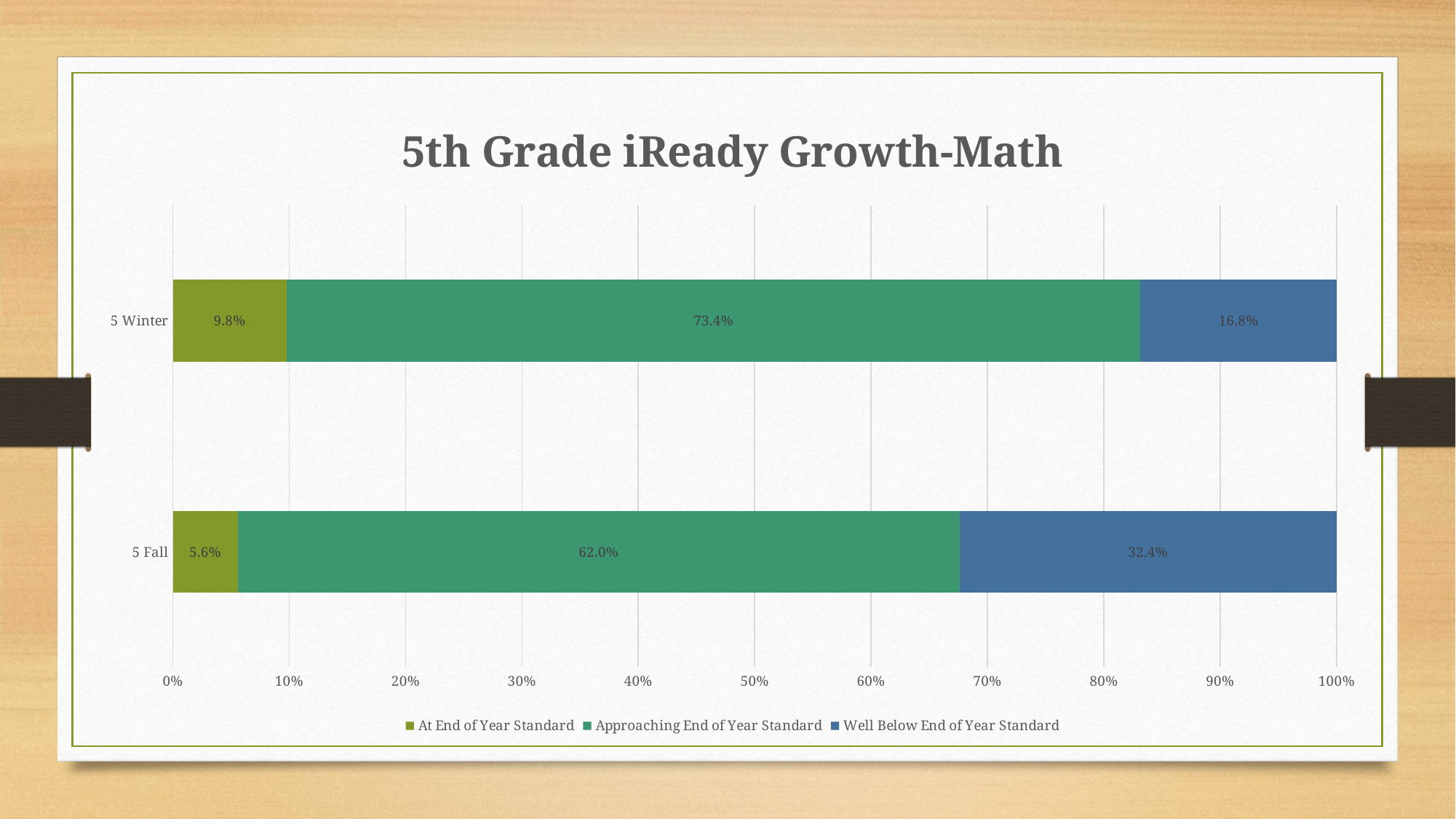
How many series does the legend list? 3 What is the value for Well Below End of Year Standard in 5 Fall? 32.4% What is the difference between the Well Below End of Year Standard values for 5 Fall and 5 Winter? 15.6% What is the value for Approaching End of Year Standard in 5 Fall? 62.0% How many categories are shown on the chart? 2 What is the value for At End of Year Standard in 5 Winter? 9.8% What is the title of the chart? 5th Grade iReady Growth-Math What is the value for Well Below End of Year Standard in 5 Winter? 16.8% What is the total of the stacked bar for 5 Fall? 100.0% What is the difference between the At End of Year Standard values for 5 Winter and 5 Fall? 4.2% Which category has the higher value for Approaching End of Year Standard, 5 Fall or 5 Winter? 5 Winter What kind of chart is shown on the slide? Stacked bar chart